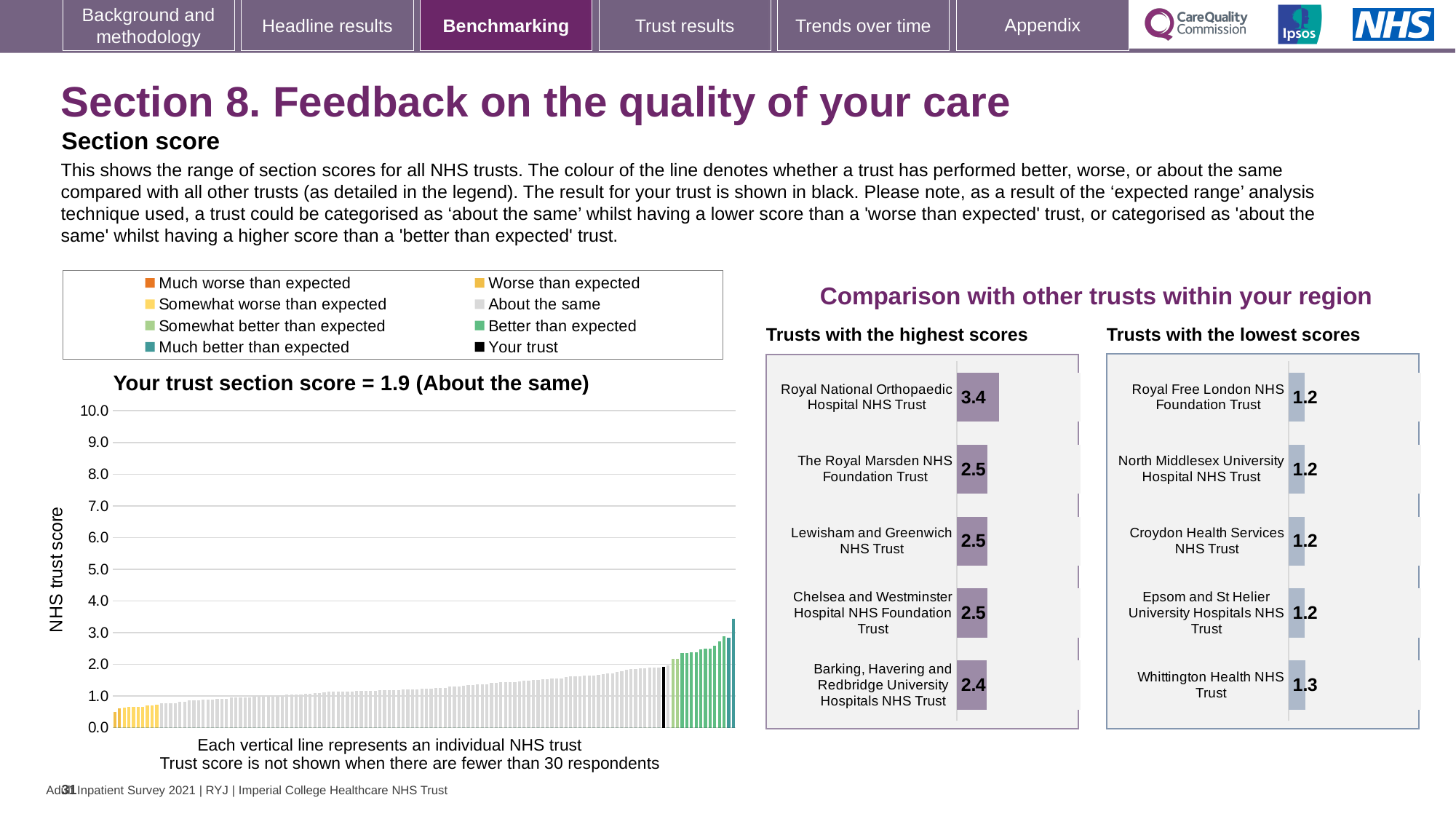
In the 'Trusts with the highest scores' chart, what is the difference between the scores of Royal National Orthopaedic Hospital NHS Trust and Barking, Havering and Redbridge University Hospitals NHS Trust? 1.0 In the 'Trusts with the highest scores' chart, what is the score for Royal National Orthopaedic Hospital NHS Trust? 3.4 In the 'Trusts with the lowest scores' chart, which is larger, the score for Whittington Health NHS Trust or the score for Croydon Health Services NHS Trust? Whittington Health NHS Trust In the 'Trusts with the lowest scores' chart, what is the score for Whittington Health NHS Trust? 1.3 In the 'Your trust section score' chart, what kind of chart is shown? bar chart In the 'Your trust section score' chart, how many entries does the legend list? 8 In the 'Your trust section score' chart, do the trust scores rise or fall from left to right along the x axis? rise In the 'Your trust section score' chart, what is the highest value shown on the y axis? 10.0 In the 'Trusts with the highest scores' chart, how many trusts are listed? 5 In the 'Your trust section score' chart, what is the section score for your trust? 1.9 In the 'Your trust section score' chart, is the value of the tallest bar greater or less than 3.0? greater In the 'Trusts with the highest scores' chart, which trust has the highest score? Royal National Orthopaedic Hospital NHS Trust